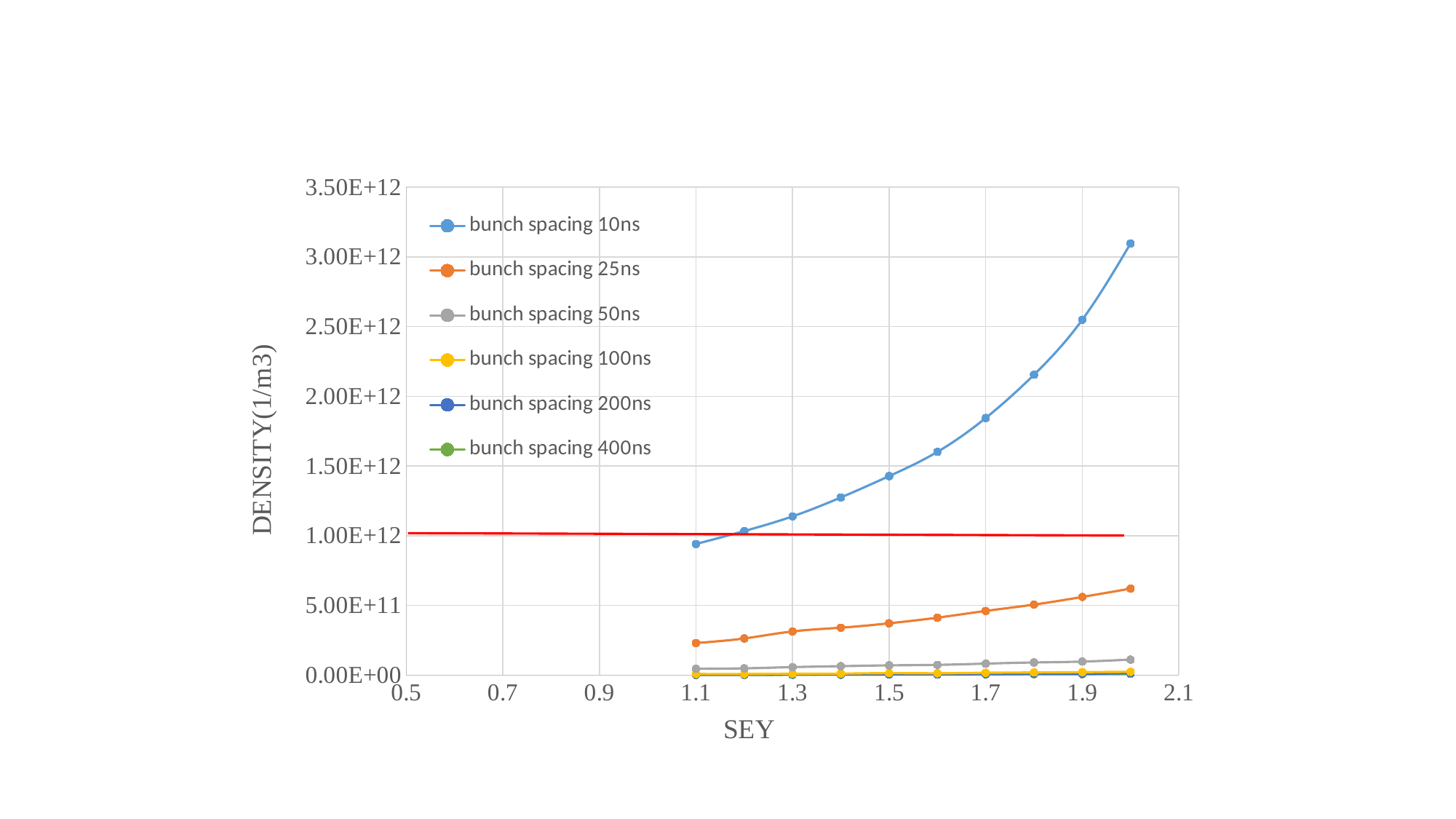
Is the density for bunch spacing 10ns at SEY 1.7 greater or less than 1.50E+12? greater What kind of chart is shown on the slide? line chart Is the density for bunch spacing 25ns at SEY 1.1 greater or less than 5.00E+11? less How many data points are plotted for the bunch spacing 10ns series? 10 How many series does the legend list? 6 Does the density for bunch spacing 10ns rise or fall as SEY increases? rises Which series reaches the highest density on the chart? bunch spacing 10ns At SEY 2.0, which series has the larger density: bunch spacing 10ns or bunch spacing 25ns? bunch spacing 10ns Does the density for bunch spacing 25ns rise or fall as SEY increases? rises Is the density for bunch spacing 25ns at SEY 2.0 greater or less than 5.00E+11? greater What is the label of the vertical axis? DENSITY(1/m3)